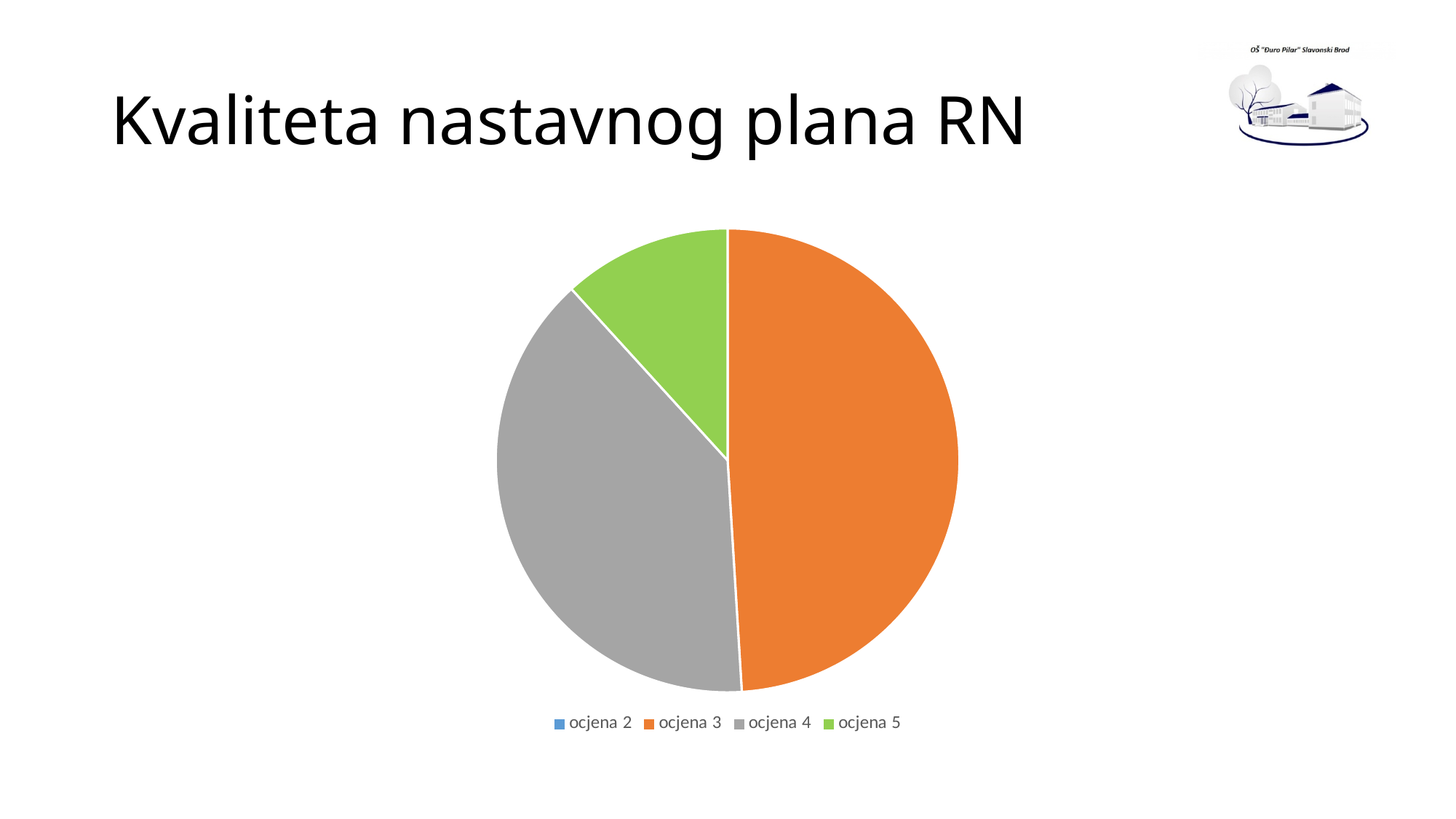
Which category has the largest slice of the pie chart? ocjena 3 Is the share of ocjena 4 in the pie chart greater or less than 25%? greater What is the title of the slide containing the pie chart? Kvaliteta nastavnog plana RN Which slice is larger, ocjena 4 or ocjena 5? ocjena 4 What kind of chart is shown on the slide? pie chart Which category has the smallest visible slice of the pie chart? ocjena 5 Which legend entry has no visible slice in the pie chart? ocjena 2 Is the share of ocjena 5 in the pie chart greater or less than 25%? less Which slice is larger, ocjena 3 or ocjena 5? ocjena 3 Which slice is larger, ocjena 3 or ocjena 4? ocjena 3 How many entries does the legend of the pie chart list? 4